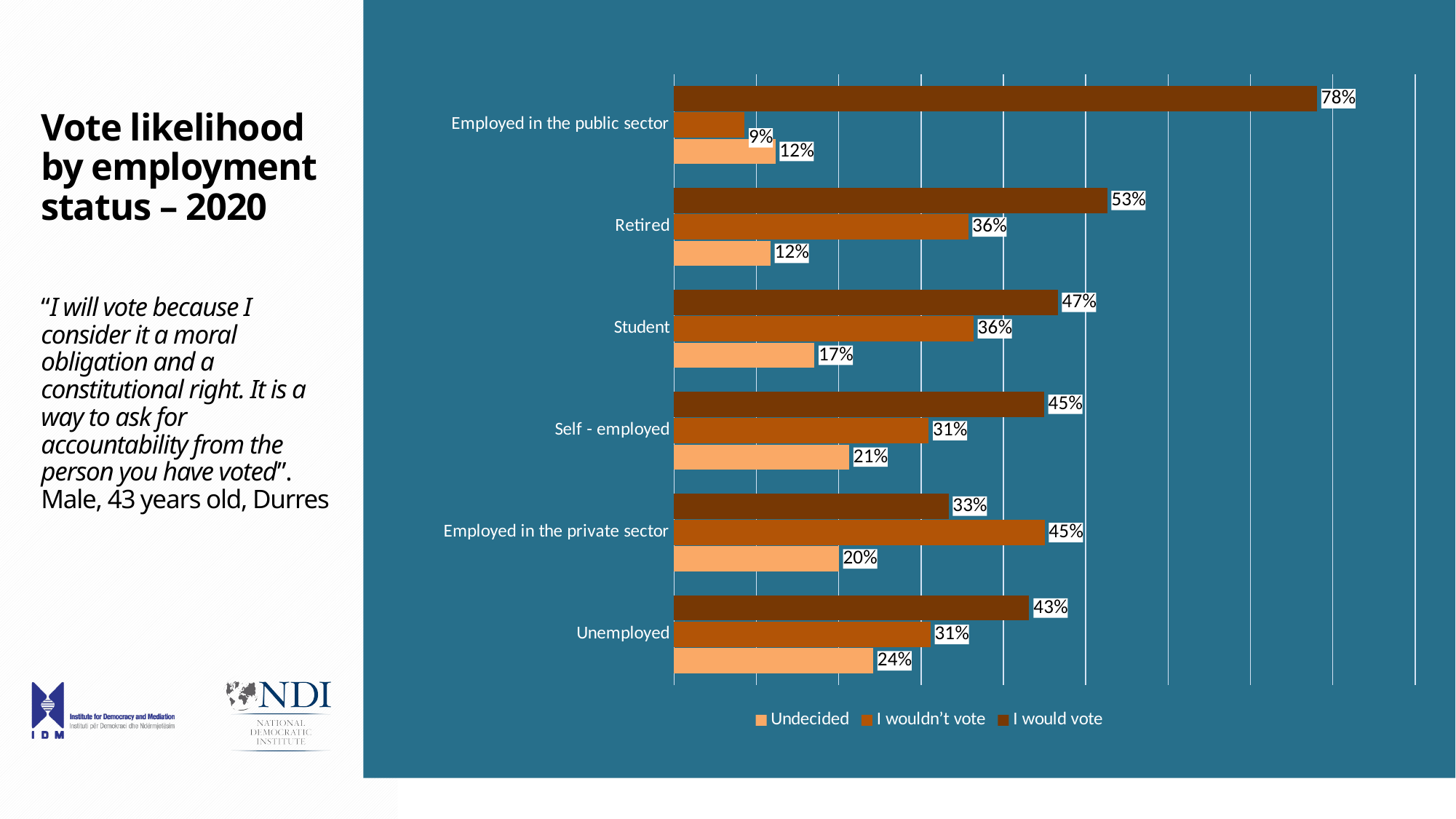
What is the difference between the "I would vote" values for Retired and Student? 6% How many series does the legend list? 3 Which employment category has the lowest "I wouldn't vote" value? Employed in the public sector What is the "I would vote" value for Employed in the private sector? 33% Which employment category has the highest "I would vote" value? Employed in the public sector What is the title of the chart on the slide? Vote likelihood by employment status – 2020 For Employed in the private sector, which is larger: "I would vote" or "I wouldn't vote"? I wouldn't vote How many employment categories are shown in the chart? 6 What kind of chart is shown on the slide? Bar chart What percentage of those employed in the public sector said "I would vote"? 78% What is the Undecided value for Unemployed? 24% What is the "I wouldn't vote" value for Retired? 36%